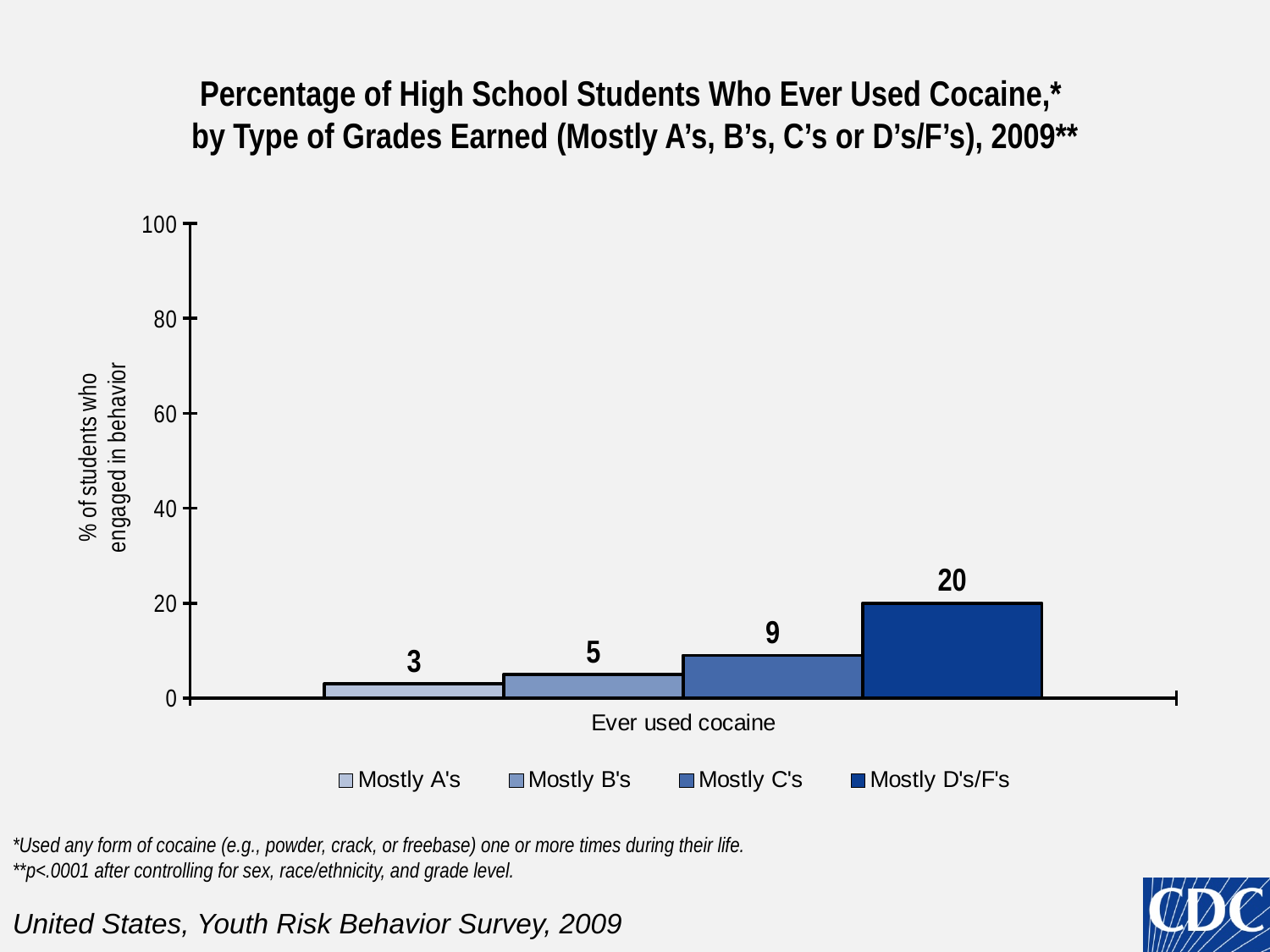
What is the value for Mostly C's? 9 Which is larger, the value for Mostly B's or Mostly C's? Mostly C's What percentage of students with mostly A's ever used cocaine? 3 What is the difference between the values for Mostly D's/F's and Mostly A's? 17 Which grade group has the highest percentage of students who ever used cocaine? Mostly D's/F's What kind of chart is shown on the slide? bar chart What is the value for Mostly D's/F's? 20 How many series does the legend list? 4 Which grade group has the lowest percentage of students who ever used cocaine? Mostly A's What is the difference between the values for Mostly C's and Mostly B's? 4 Is the value for Mostly D's/F's greater or less than 40? less What is the label on the y axis? % of students who engaged in behavior